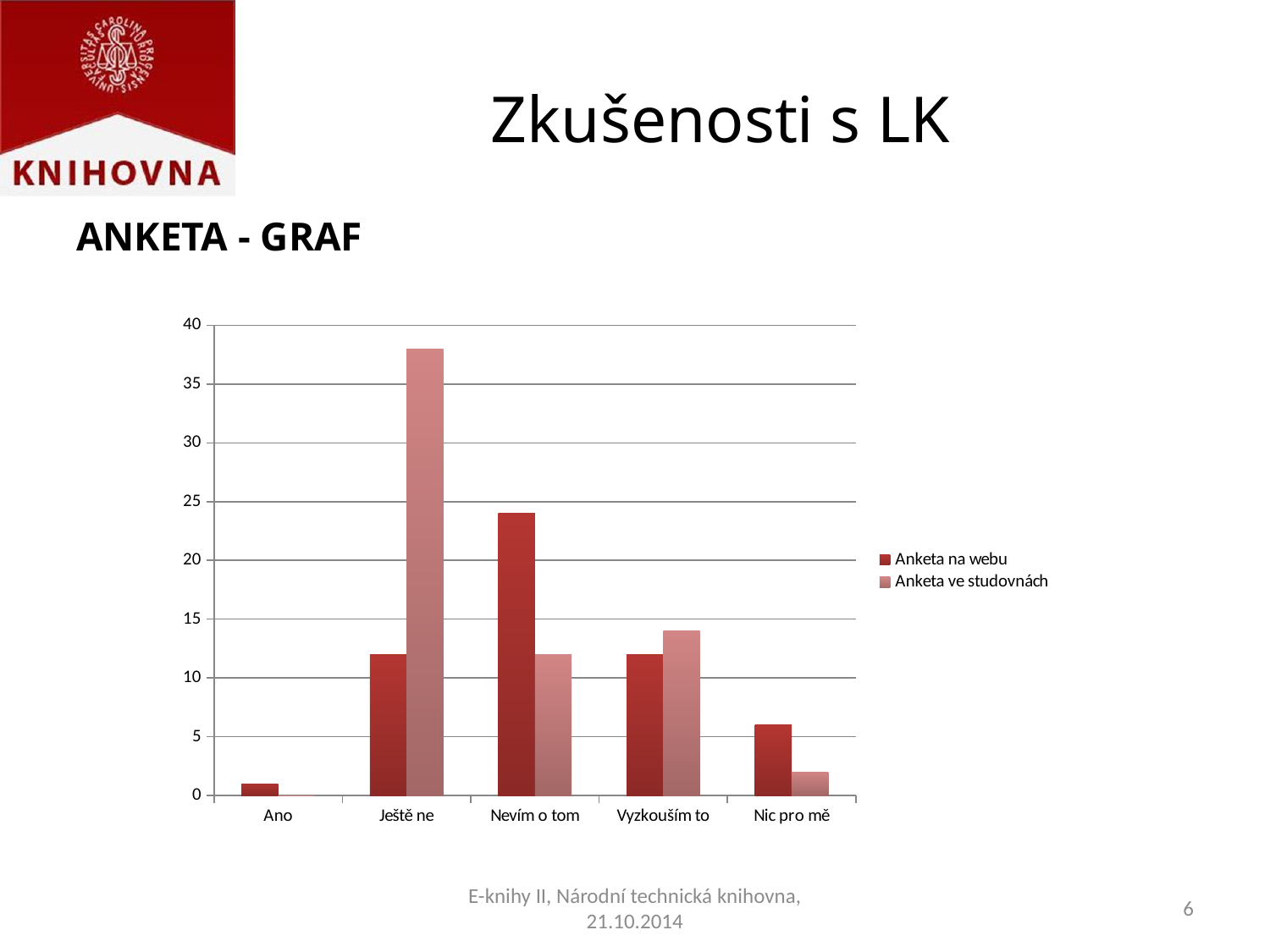
Is the value for Ještě ne in the series Anketa ve studovnách greater or less than 35? greater For the category Ještě ne, which series has the larger value: Anketa na webu or Anketa ve studovnách? Anketa ve studovnách What kind of chart is shown on the slide? bar chart For the category Nevím o tom, which series has the larger value: Anketa na webu or Anketa ve studovnách? Anketa na webu For the series Anketa na webu, which category has the highest value? Nevím o tom Is the value for Nevím o tom in the series Anketa na webu greater or less than 20? greater How many series does the legend list? 2 Is the value for Nic pro mě in the series Anketa na webu greater or less than 10? less How many categories are shown on the x axis of the chart? 5 Which category has the tallest bar in the chart? Ještě ne For the series Anketa na webu, which category has the lowest value? Ano What are the two series names listed in the legend? Anketa na webu, Anketa ve studovnách